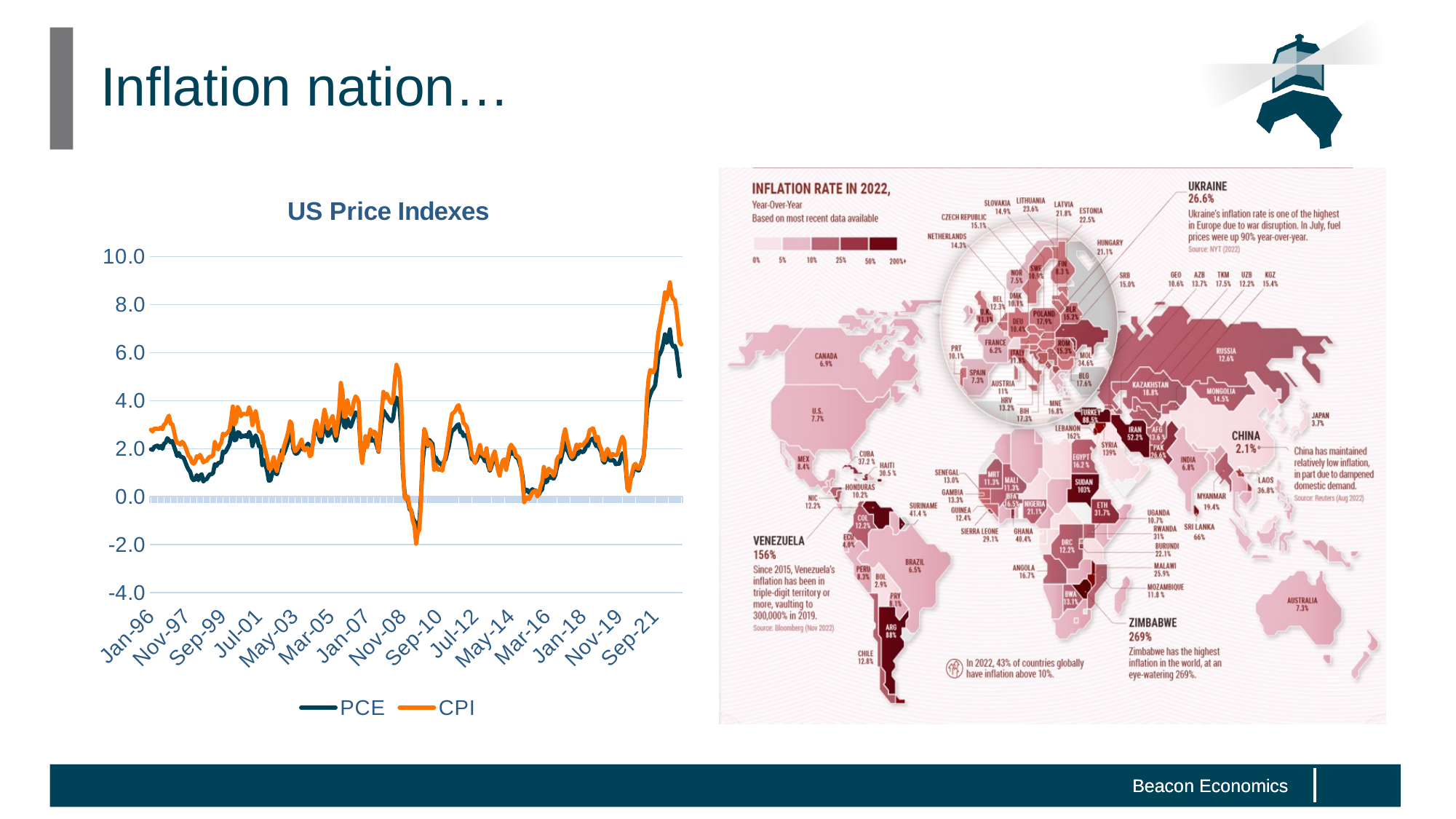
What kind of chart is the "US Price Indexes" chart? line chart In the "US Price Indexes" chart, is the peak value of PCE around 2022 greater or less than 6.0? greater On the "Inflation Rate in 2022" map, what is the inflation rate shown for Zimbabwe? 269% In the "US Price Indexes" chart, which series reaches the higher peak around 2022, PCE or CPI? CPI On the "Inflation Rate in 2022" map, what is the inflation rate shown for Venezuela? 156% In the "US Price Indexes" chart, which series is drawn in orange? CPI In the "US Price Indexes" chart, do the values rise or fall between Nov-19 and Sep-21? rise What is the highest value shown on the vertical axis of the "US Price Indexes" chart? 10.0 In the "US Price Indexes" chart, is the peak value of CPI around 2022 greater or less than 8.0? greater What are the two series named in the legend of the "US Price Indexes" chart? PCE and CPI In the "US Price Indexes" chart, is the lowest value of CPI (around 2009) greater or less than 0.0? less How many series does the legend of the "US Price Indexes" chart list? 2